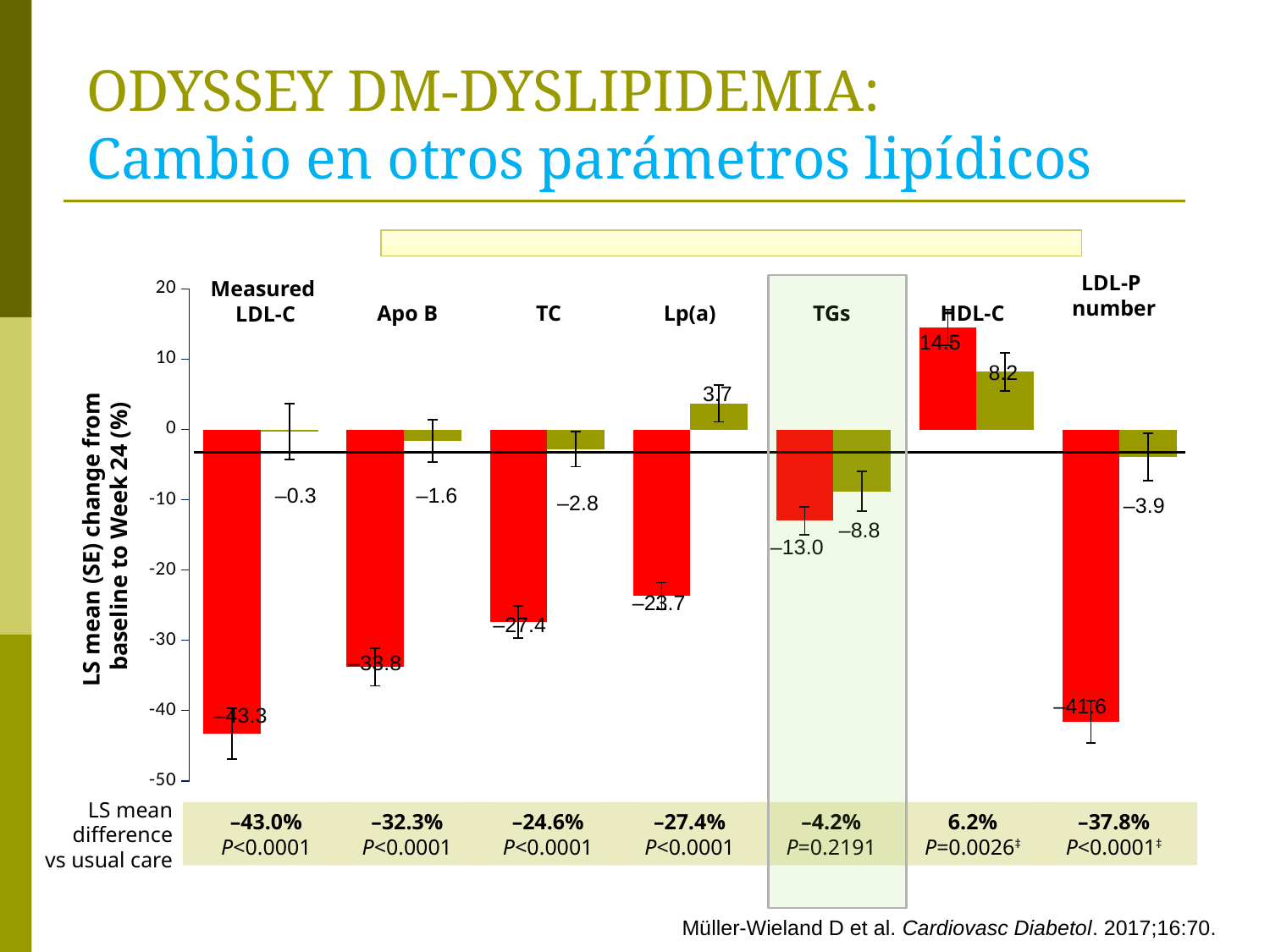
What is the LS mean difference vs usual care shown for LDL-P number? –37.8% Which category has the lowest red bar value? Measured LDL-C Which is larger, the olive bar value for Apo B or the olive bar value for TC? Apo B What is the difference between the red bar and the olive bar for HDL-C? 6.3 What is the value of the red bar for TGs? –13.0 What is the value of the olive bar for Lp(a)? 3.7 What is the value of the red (left-hand) bar for HDL-C? 14.5 How many lipid parameter categories are shown along the x axis of the chart? 7 What is the value of the olive (right-hand) bar for TGs? –8.8 Which category has the highest red bar value? HDL-C What P value is shown for the LS mean difference vs usual care for TGs? P=0.2191 What kind of chart is shown on the slide? bar chart